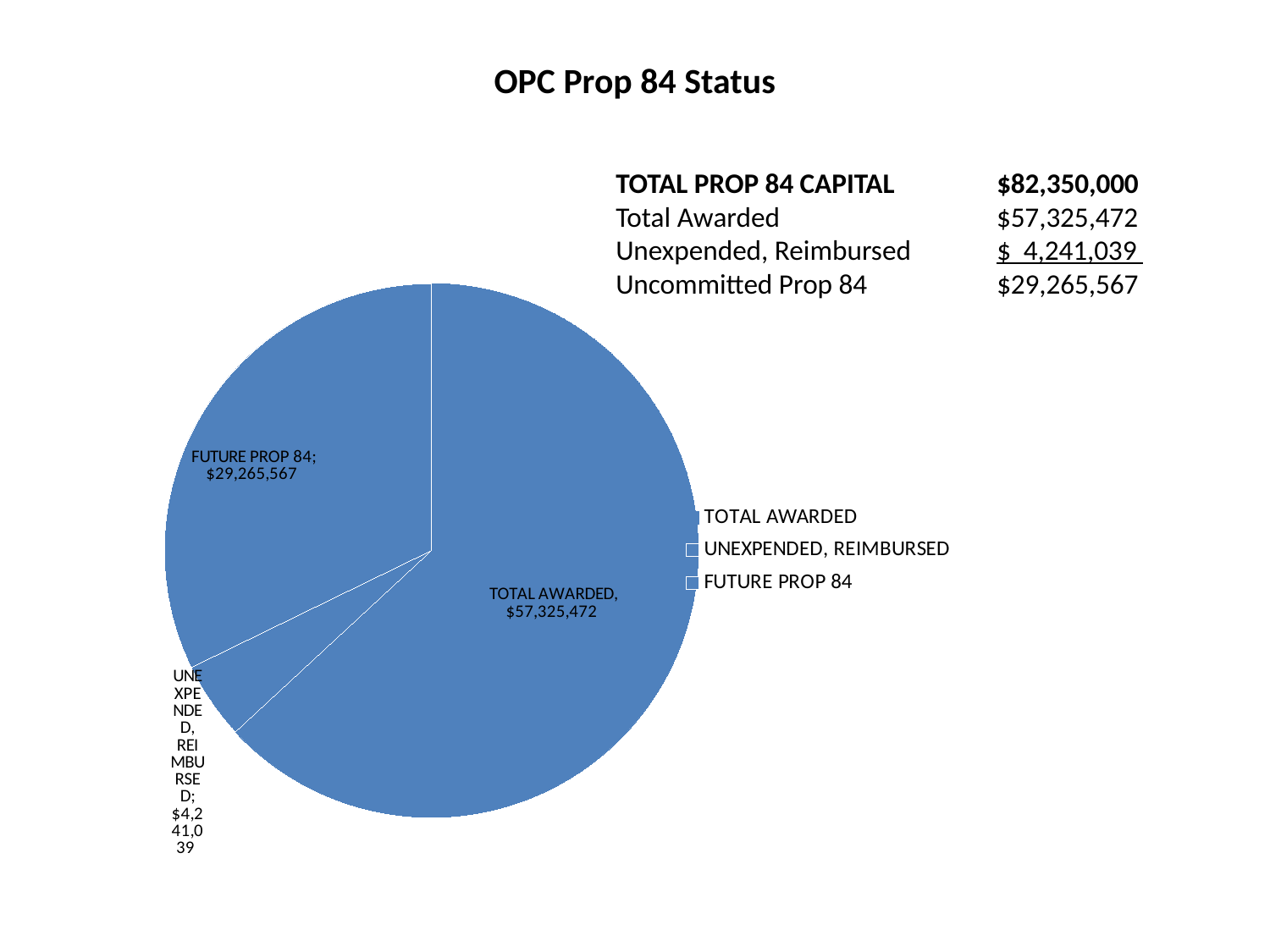
Which slice of the pie chart is the largest? TOTAL AWARDED Which is larger in the pie chart, FUTURE PROP 84 or UNEXPENDED, REIMBURSED? FUTURE PROP 84 What is the difference between the TOTAL AWARDED slice and the FUTURE PROP 84 slice in the pie chart? $28,059,905 What is the value of the TOTAL AWARDED slice in the pie chart? $57,325,472 What is the value of the UNEXPENDED, REIMBURSED slice in the pie chart? $4,241,039 How many slices does the pie chart have? 3 How many entries does the pie chart's legend list? 3 What is the title shown at the top of the slide above the pie chart? OPC Prop 84 Status Which slice of the pie chart is the smallest? UNEXPENDED, REIMBURSED What is the value of the FUTURE PROP 84 slice in the pie chart? $29,265,567 What is the difference between the FUTURE PROP 84 slice and the UNEXPENDED, REIMBURSED slice in the pie chart? $25,024,528 What kind of chart is shown on the slide? pie chart